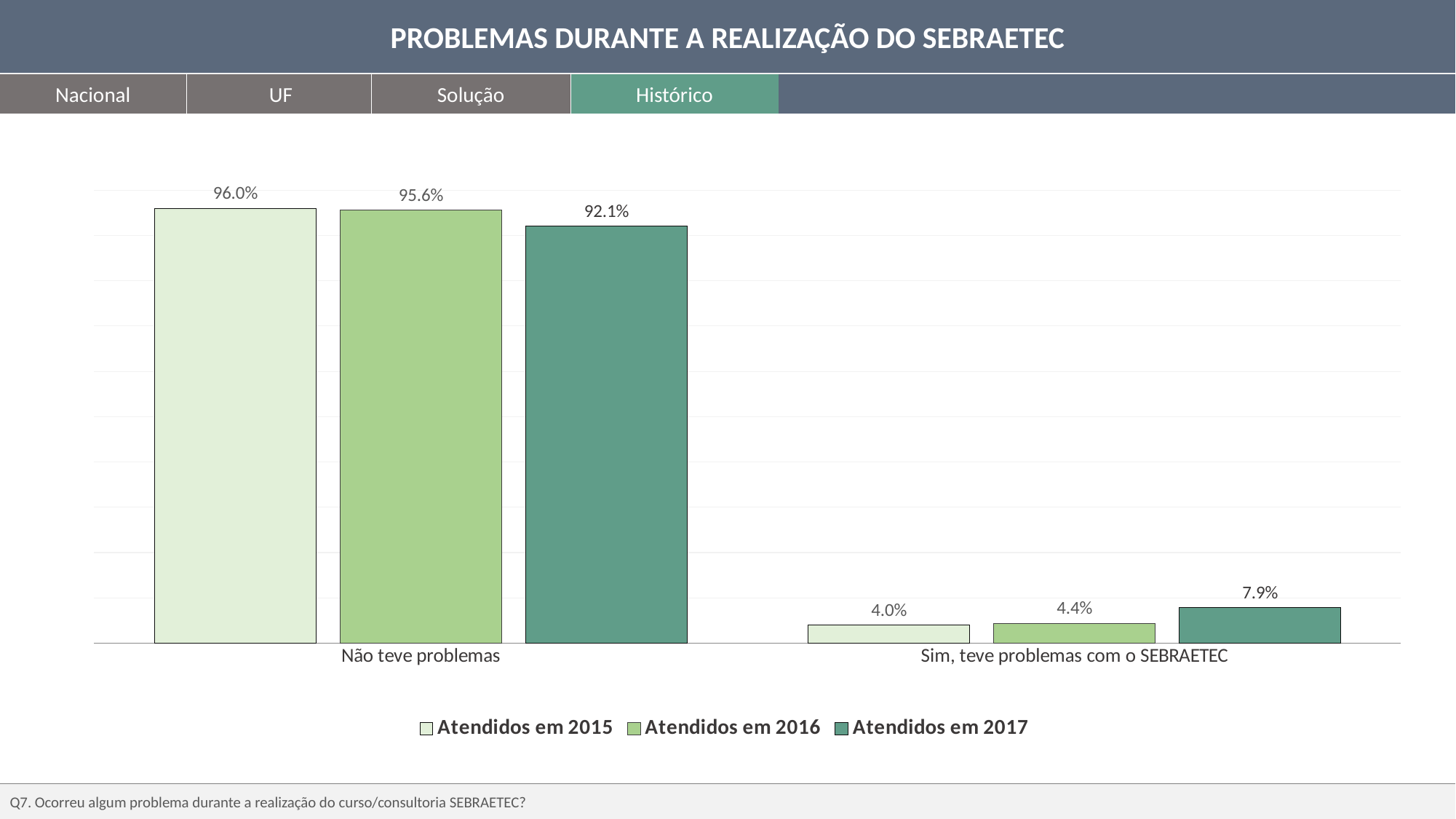
What is the difference between the 'Atendidos em 2017' and 'Atendidos em 2016' values for 'Sim, teve problemas com o SEBRAETEC'? 3.5% What is the value for 'Sim, teve problemas com o SEBRAETEC' in the 'Atendidos em 2017' series? 7.9% How many categories are shown on the x axis? 2 What is the value for 'Não teve problemas' in the 'Atendidos em 2015' series? 96.0% Which is larger for 'Sim, teve problemas com o SEBRAETEC': the 'Atendidos em 2016' value or the 'Atendidos em 2017' value? Atendidos em 2017 What kind of chart is shown on the slide? Bar chart Which series has the lowest value for 'Sim, teve problemas com o SEBRAETEC'? Atendidos em 2015 What is the difference between the 'Atendidos em 2015' and 'Atendidos em 2017' values for 'Não teve problemas'? 3.9% Which series has the highest value for 'Não teve problemas'? Atendidos em 2015 How many series does the legend list? 3 What is the value for 'Sim, teve problemas com o SEBRAETEC' in the 'Atendidos em 2015' series? 4.0% What is the value for 'Não teve problemas' in the 'Atendidos em 2016' series? 95.6%